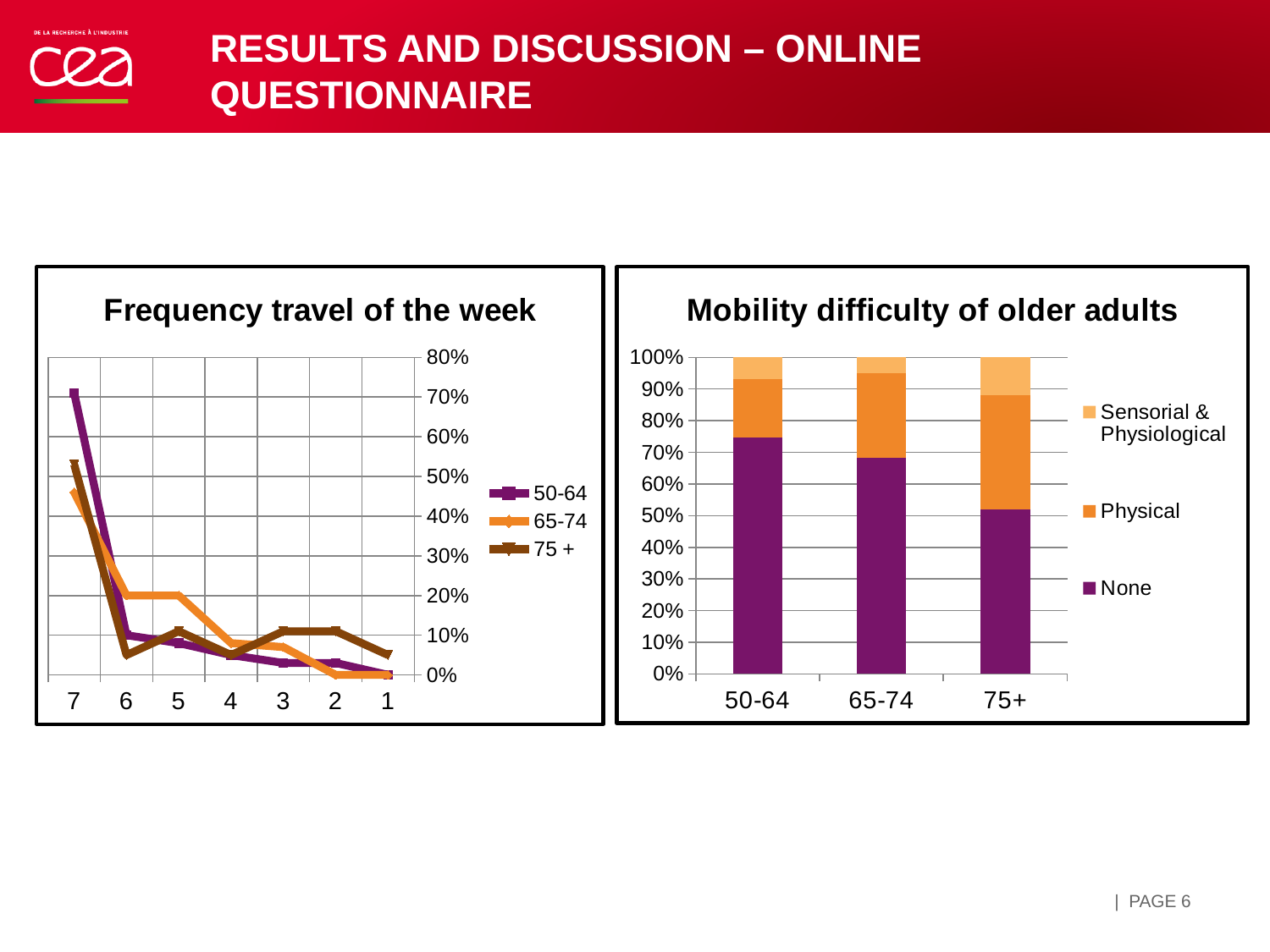
What kind of chart is the "Frequency travel of the week" chart? line chart In the "Frequency travel of the week" chart, which series has the highest value at category 7? 50-64 How many series does the legend of the "Frequency travel of the week" chart list? 3 How many series does the legend of the "Mobility difficulty of older adults" chart list? 3 In the "Frequency travel of the week" chart, do the values generally rise or fall moving from category 7 to category 1 along the x axis? fall In the "Mobility difficulty of older adults" chart, is the "None" share for the 50-64 group greater or less than 70%? greater In the "Frequency travel of the week" chart, is the value for the 50-64 series at category 7 greater or less than 60%? greater How many age groups are shown on the x axis of the "Mobility difficulty of older adults" chart? 3 What kind of chart is the "Mobility difficulty of older adults" chart? stacked bar chart In the "Frequency travel of the week" chart, is the value for the 75 + series at category 6 greater or less than 10%? less In the "Mobility difficulty of older adults" chart, which age group has the largest "None" share? 50-64 How many categories are shown on the x axis of the "Frequency travel of the week" chart? 7